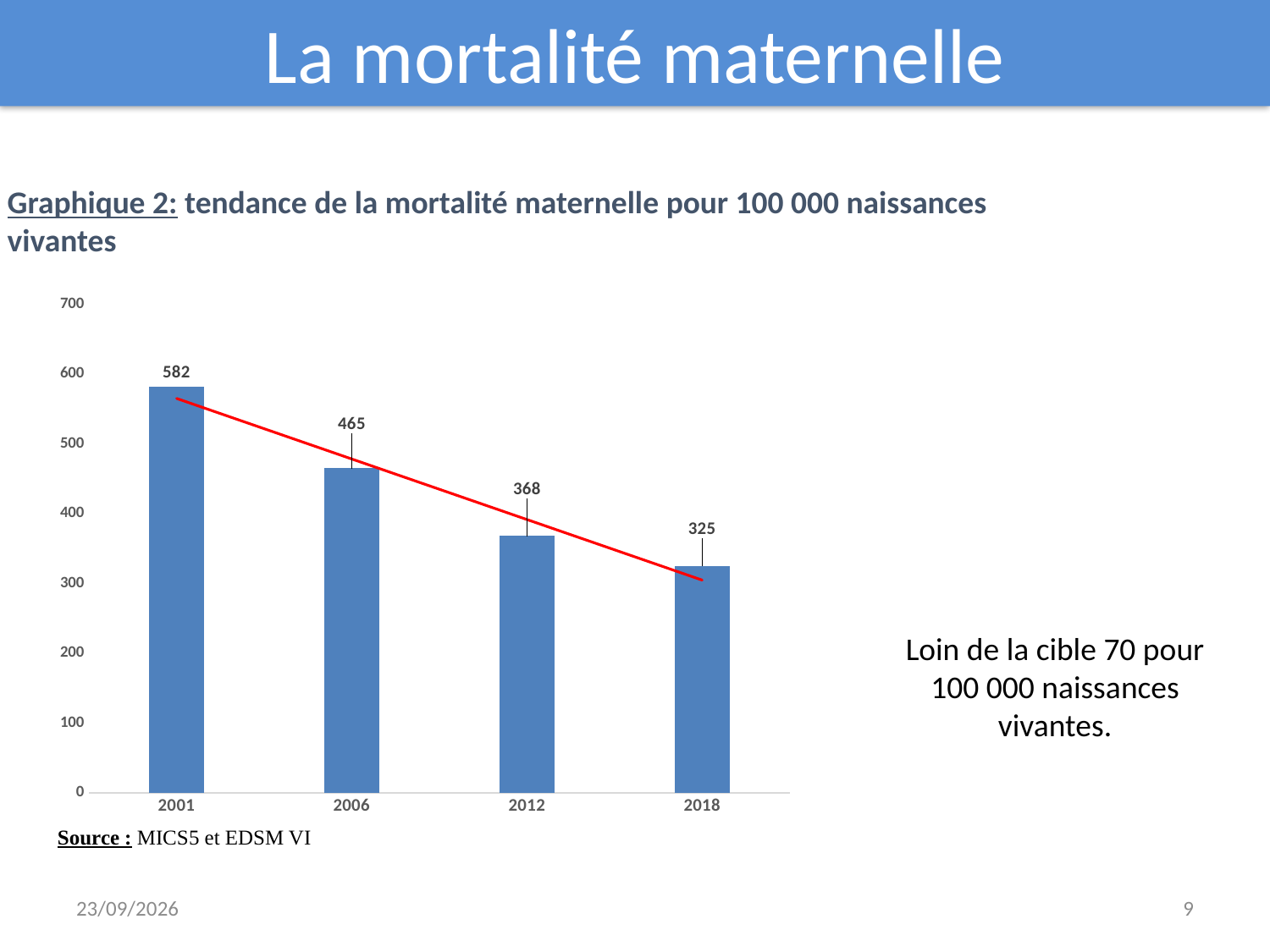
Which year has the highest maternal mortality value? 2001 How many years are shown on the x axis? 4 Which is larger, the value for 2006 or the value for 2012? 2006 What is the difference between the values for 2001 and 2018? 257 What is the maternal mortality value for 2018? 325 What is the difference between the values for 2006 and 2012? 97 What is the maternal mortality value for 2012? 368 Do the values rise or fall from 2001 to 2018? fall What is the maternal mortality value for 2001? 582 What kind of chart is shown on the slide? bar chart What is the maternal mortality value for 2006? 465 Which year has the lowest maternal mortality value? 2018